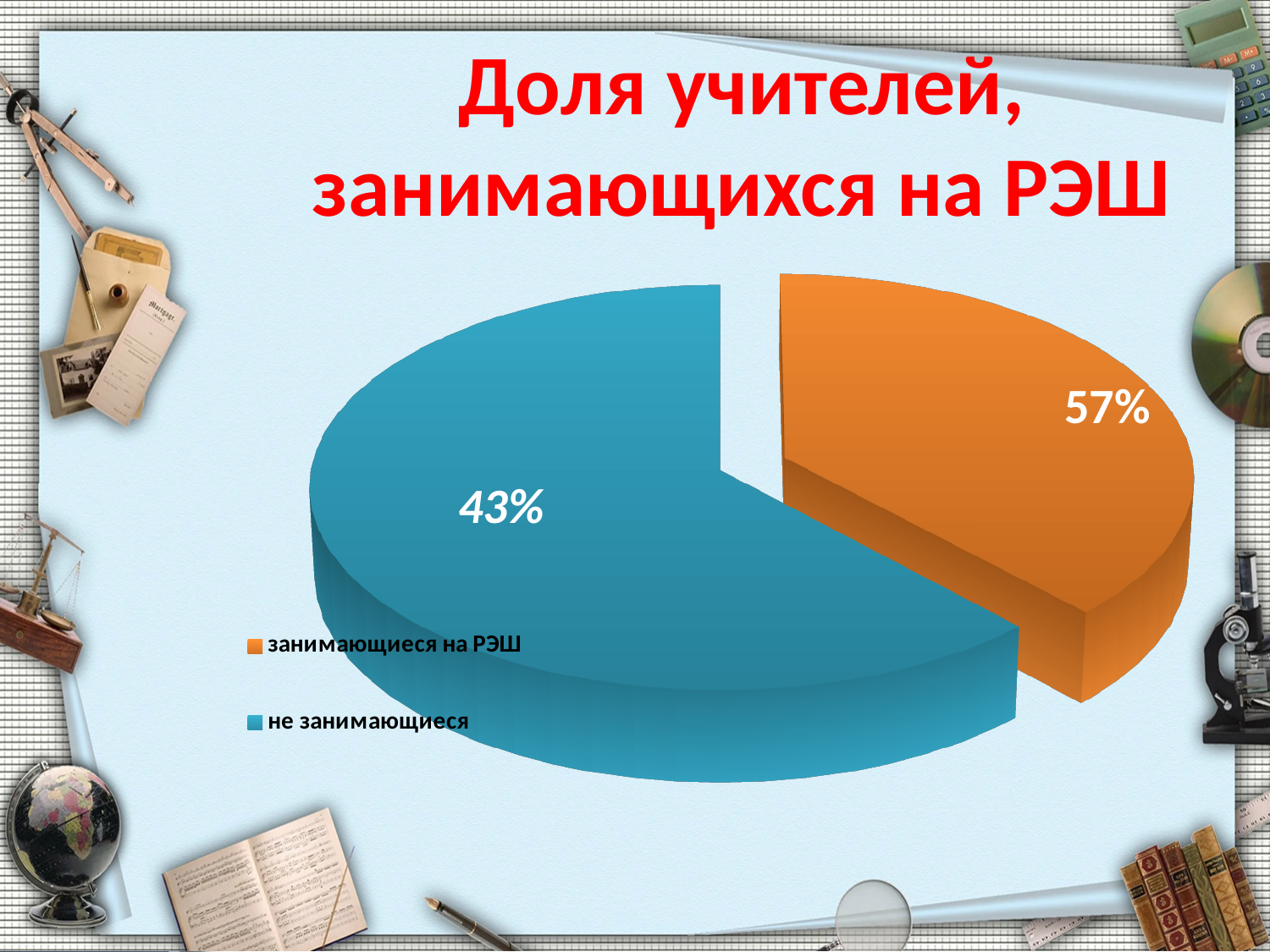
How many slices does the pie chart have? 2 What is the difference in percentage points between the two printed values, 57% and 43%? 14 What percentage is printed on the slice labelled 'занимающиеся на РЭШ'? 57% Is the value printed for 'занимающиеся на РЭШ' greater or less than 50%? greater What kind of chart is shown on the slide? pie chart What colour is the slice for 'занимающиеся на РЭШ' in the legend? orange What do the two printed percentages on the pie chart add up to? 100% How many entries does the legend list? 2 What percentage is printed on the slice labelled 'не занимающиеся'? 43% Is the value printed for 'не занимающиеся' greater or less than 50%? less What is the title of the chart on the slide? Доля учителей, занимающихся на РЭШ